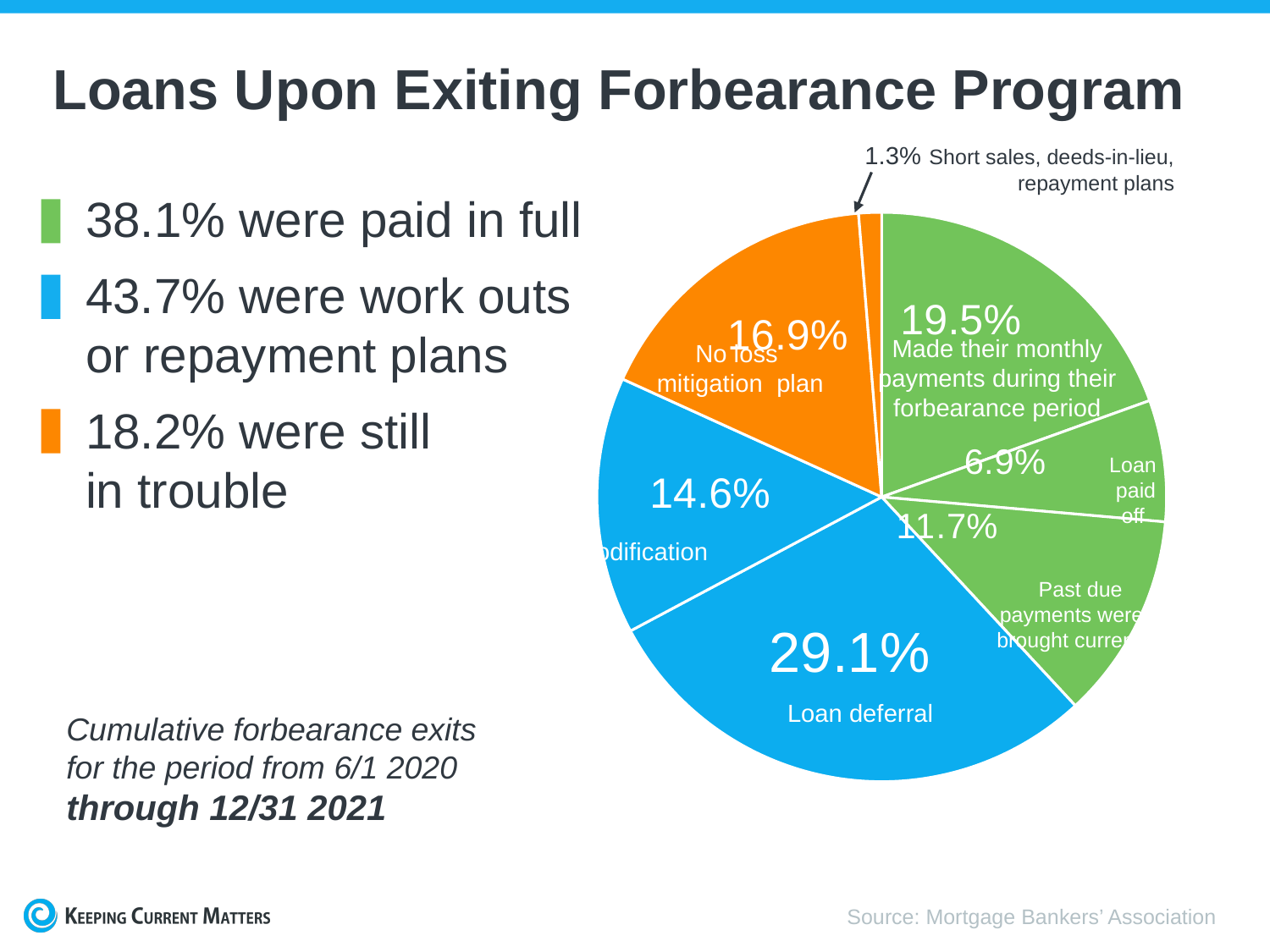
Which is larger: the share of loans paid off or the share with past due payments brought current? Past due payments were brought current What kind of chart is shown on the slide? pie chart What percentage of loans were paid off? 6.9% What share of loans made their monthly payments during their forbearance period? 19.5% How many slices does the pie chart have? 7 What is the title of the slide containing the pie chart? Loans Upon Exiting Forbearance Program What percentage of loans had no loss mitigation plan? 16.9% What percentage is shown for short sales, deeds-in-lieu, repayment plans? 1.3% How many percentage points larger is the loan deferral slice than the no loss mitigation plan slice? 12.2% Which slice of the pie chart is the smallest? Short sales, deeds-in-lieu, repayment plans What share of loans exiting forbearance went into a loan deferral? 29.1% Which slice of the pie chart is the largest? Loan deferral